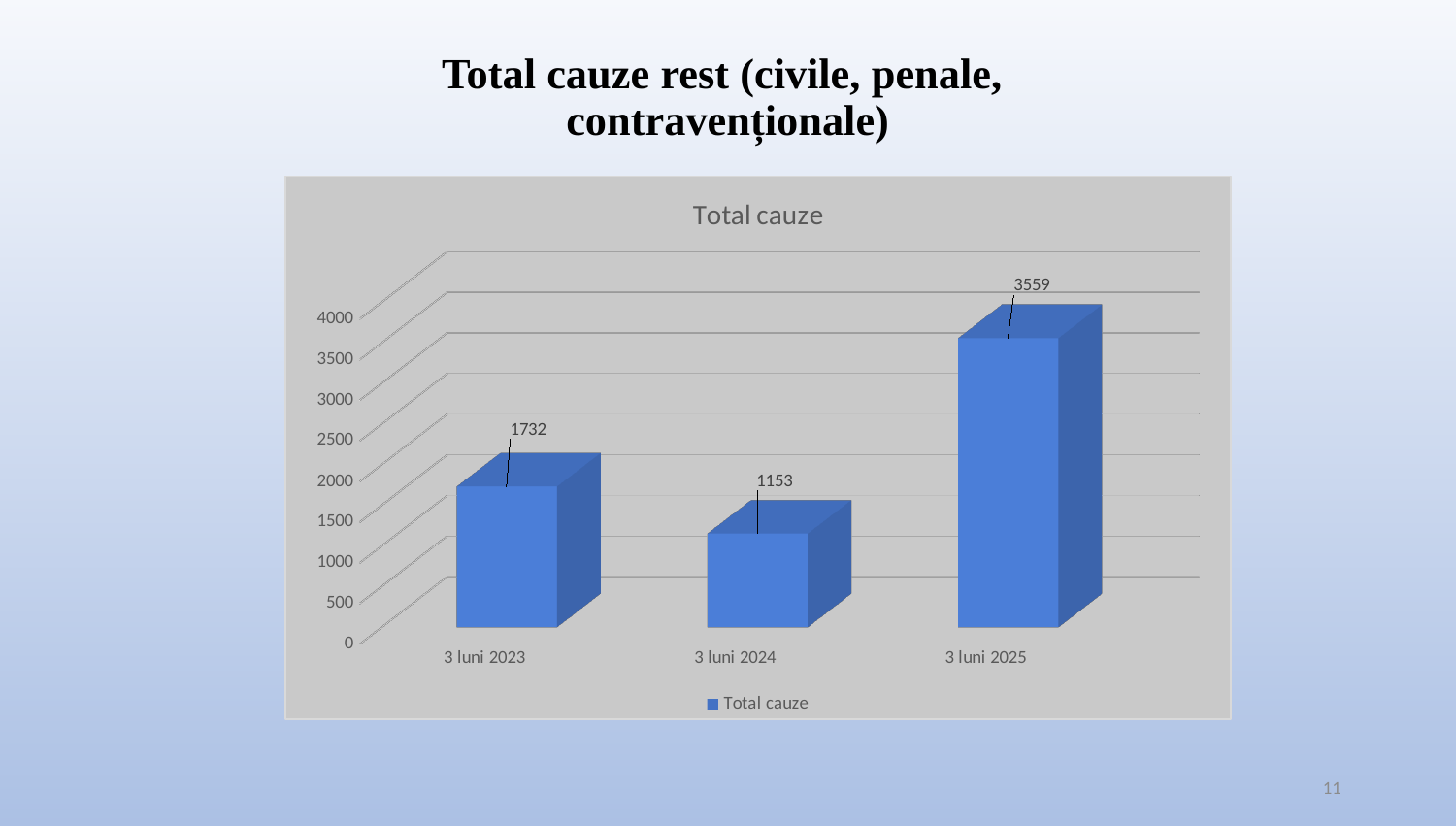
What is the difference between the values for 3 luni 2023 and 3 luni 2024? 579 What is the title of the chart? Total cauze Which category has the lowest value? 3 luni 2024 Which is larger, the value for 3 luni 2023 or 3 luni 2024? 3 luni 2023 Which category has the highest value? 3 luni 2025 How many series does the legend list? 1 What is the value for 3 luni 2023? 1732 What is the value for 3 luni 2025? 3559 What is the difference between the values for 3 luni 2025 and 3 luni 2023? 1827 How many categories are shown on the x axis? 3 What is the value for 3 luni 2024? 1153 What kind of chart is shown? bar chart